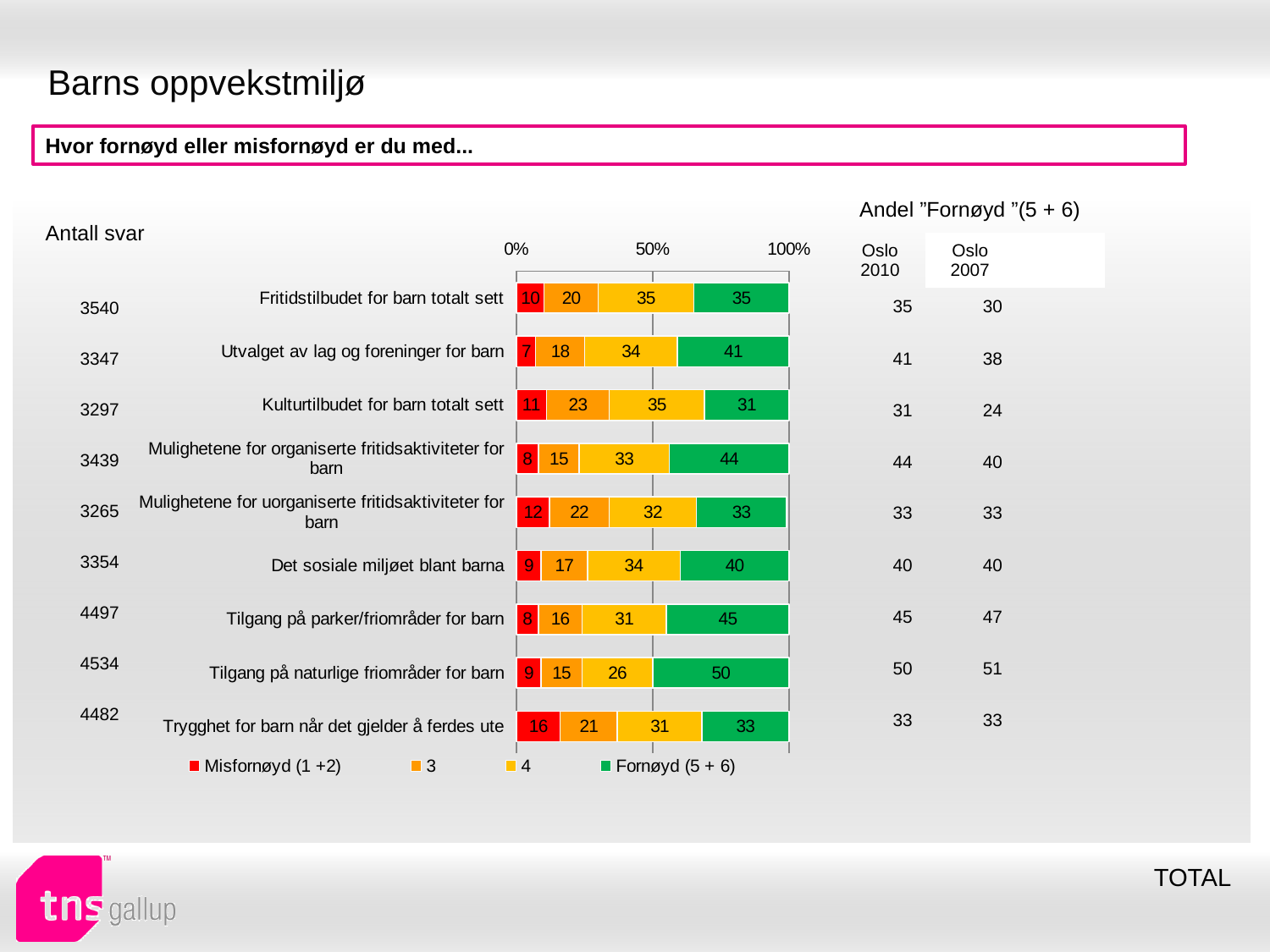
What type of chart is shown on the slide? stacked bar chart What is the 'Fornøyd (5 + 6)' value for 'Tilgang på naturlige friområder for barn'? 50 What is the total of the stacked bar for 'Det sosiale miljøet blant barna'? 100 How many categories (questions) are plotted in the chart? 9 What is the first entry in the chart legend? Misfornøyd (1 +2) What is the difference between the 'Fornøyd (5 + 6)' values for 'Tilgang på parker/friområder for barn' and 'Fritidstilbudet for barn totalt sett'? 10 What is the 'Misfornøyd (1 +2)' value for 'Trygghet for barn når det gjelder å ferdes ute'? 16 Which category has the lowest 'Fornøyd (5 + 6)' value? Kulturtilbudet for barn totalt sett How many series does the chart legend list? 4 What is the value of series '3' for 'Kulturtilbudet for barn totalt sett'? 23 Which category has the highest 'Fornøyd (5 + 6)' value? Tilgang på naturlige friområder for barn Which has a larger 'Misfornøyd (1 +2)' value: 'Mulighetene for uorganiserte fritidsaktiviteter for barn' or 'Utvalget av lag og foreninger for barn'? Mulighetene for uorganiserte fritidsaktiviteter for barn